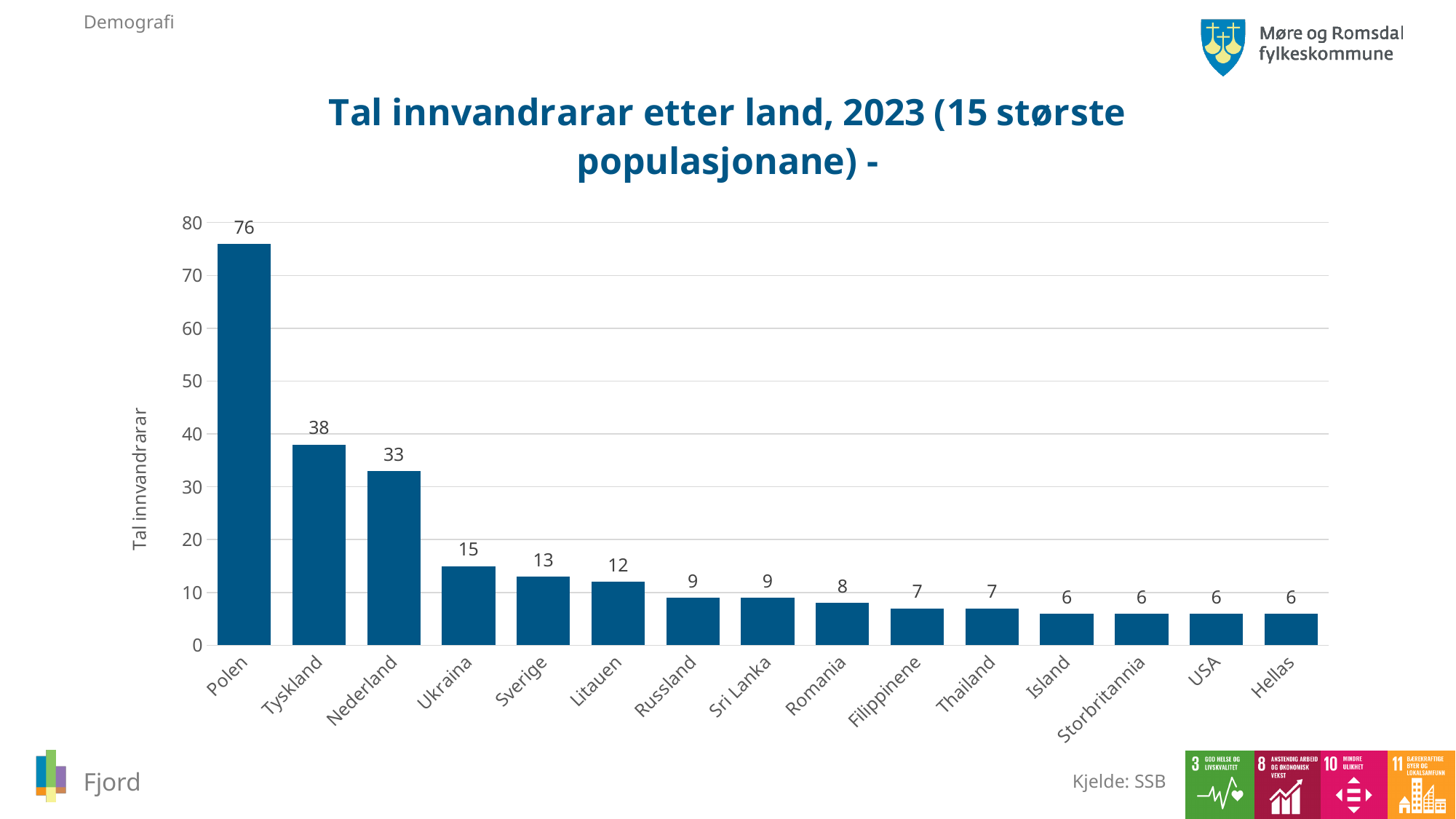
Is the value for Nederland greater or less than 30? greater What kind of chart is shown on the slide? bar chart What is the label of the y axis? Tal innvandrarar Which is larger, the value for Sverige or the value for Litauen? Sverige What is the value for Polen? 76 Do the values rise or fall from left to right along the x axis? fall What is the value for Ukraina? 15 How many countries are shown on the chart? 15 Which country has the highest number of immigrants? Polen What is the difference between the values for Tyskland and Nederland? 5 What is the value for Romania? 8 What is the difference between the values for Polen and Tyskland? 38